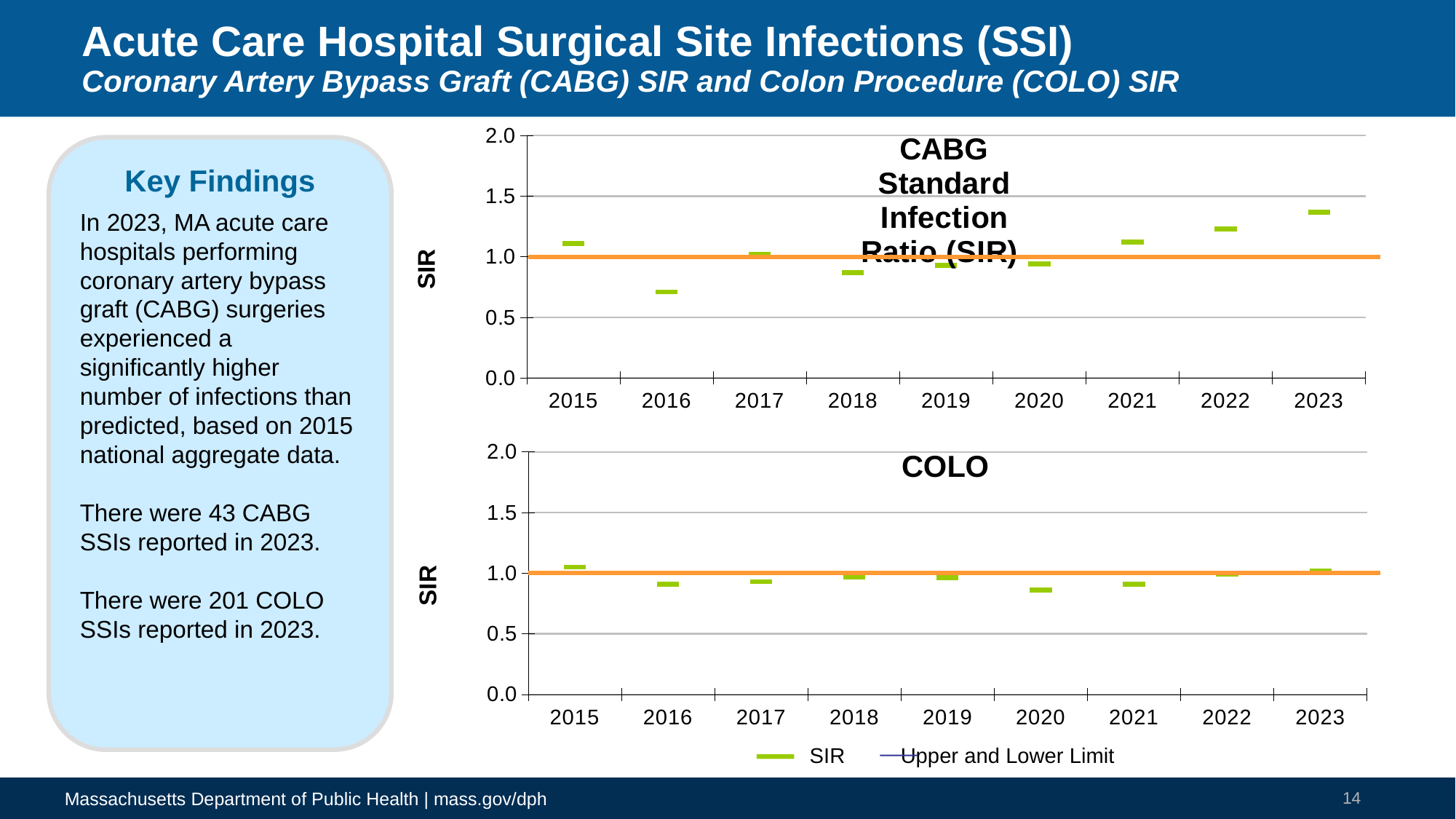
In the COLO chart, which year has the lowest SIR? 2020 In the CABG Standard Infection Ratio (SIR) chart, which year has the lowest SIR? 2016 In the CABG Standard Infection Ratio (SIR) chart, is the SIR for 2023 greater or less than 1.0? greater In the CABG Standard Infection Ratio (SIR) chart, does the SIR rise or fall from 2020 to 2023? rise In the CABG Standard Infection Ratio (SIR) chart, is the SIR for 2016 greater or less than 1.0? less How many series does the legend below the COLO chart list? 2 In the CABG Standard Infection Ratio (SIR) chart, is the SIR for 2022 greater or less than 1.5? less In the CABG Standard Infection Ratio (SIR) chart, which year has the highest SIR? 2023 What value on the SIR axis does the orange Upper and Lower Limit line sit at in the COLO chart? 1.0 In the CABG Standard Infection Ratio (SIR) chart, which year has the larger SIR, 2016 or 2023? 2023 How many years are plotted on the x axis of the COLO chart? 9